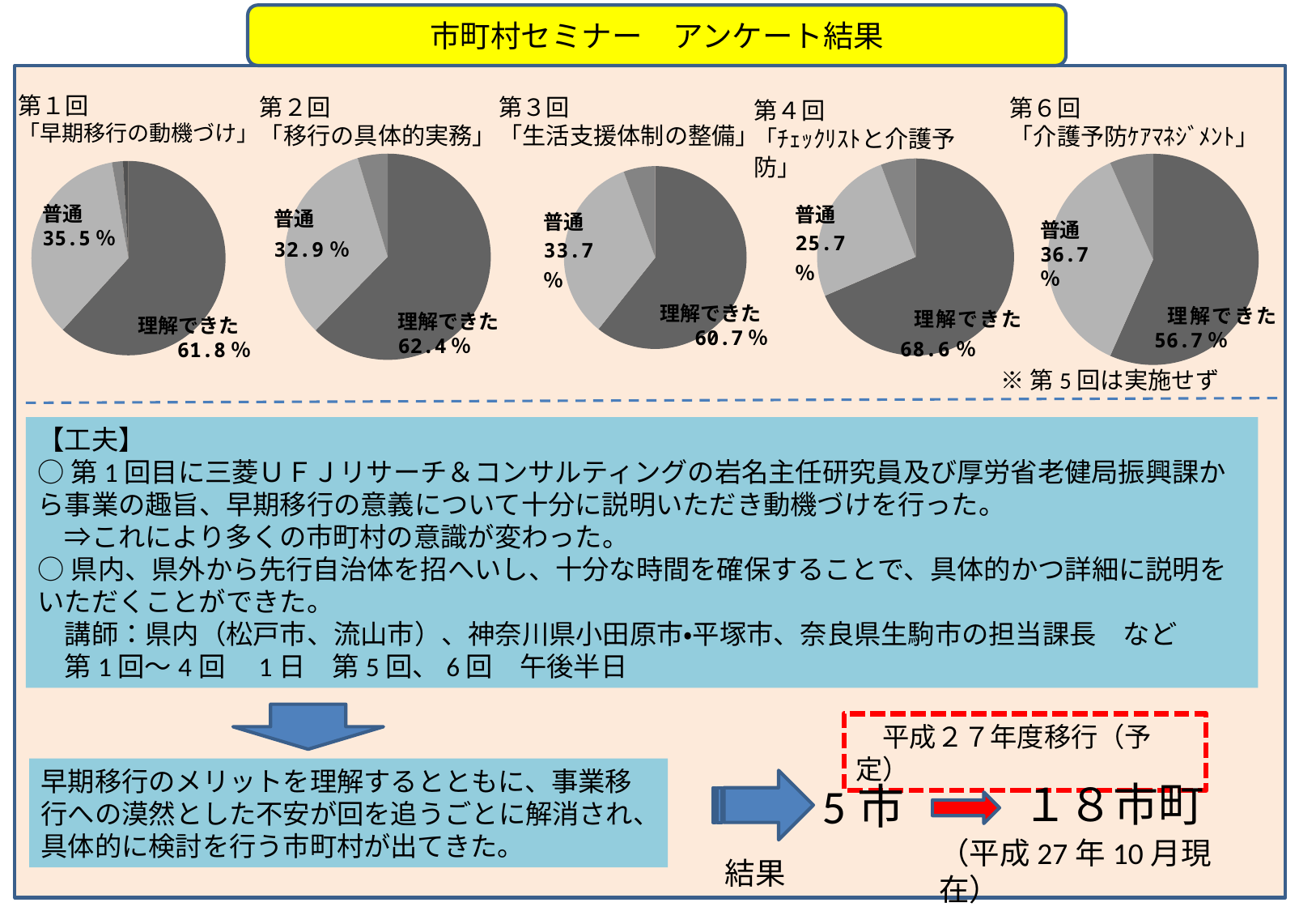
How many pie charts are shown on the slide? 5 Across the five pie charts, which session has the highest 理解できた percentage? 第４回 In the 第６回 pie chart, which slice is larger, 理解できた or 普通? 理解できた In the 第４回 pie chart, what percentage is labelled 普通? 25.7％ What kind of chart is used to show the seminar survey results? Pie chart In the 第４回 pie chart, what is the difference between the 理解できた and 普通 percentages? 42.9％ In the 第１回 pie chart, what is the difference between the 理解できた and 普通 percentages? 26.3％ In the 第３回「生活支援体制の整備」 pie chart, what percentage is labelled 理解できた? 60.7％ In the 第６回「介護予防ケアマネジメント」 pie chart, what percentage is labelled 理解できた? 56.7％ Across the five pie charts, which session has the lowest 理解できた percentage? 第６回 In the 第２回「移行の具体的実務」 pie chart, what percentage is labelled 普通? 32.9％ In the 第１回「早期移行の動機づけ」 pie chart, what percentage is labelled 理解できた? 61.8％